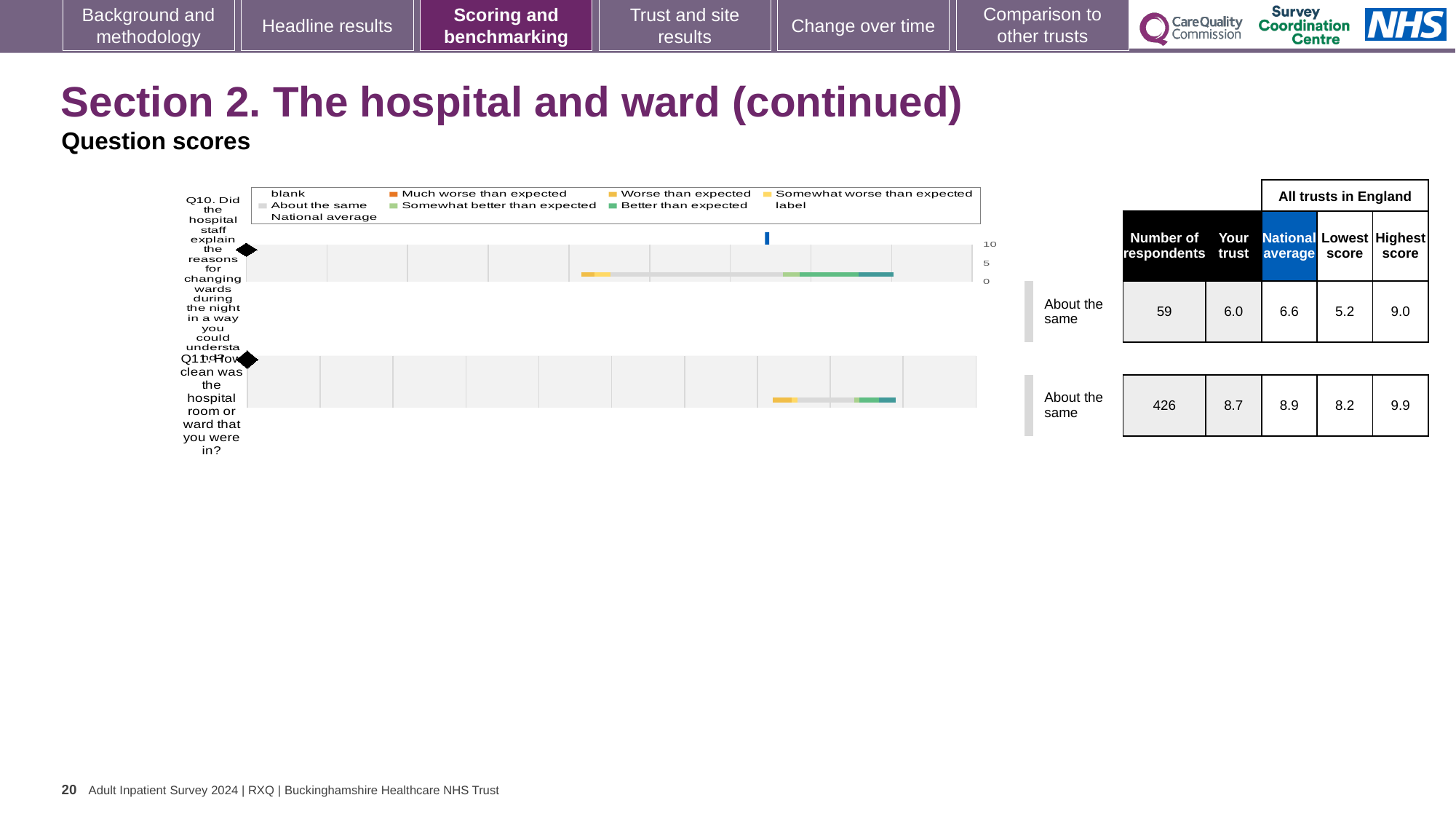
What is the highest score across all trusts in England for Q11? 9.9 How many respondents answered Q11? 426 What benchmarking category is the trust's score for Q10 placed in? About the same What is the 'Your trust' score for Q11 (How clean was the hospital room or ward that you were in?)? 8.7 What is the national average score for Q10 (Did the hospital staff explain the reasons for changing wards during the night)? 6.6 What is the lowest score across all trusts in England for Q10? 5.2 What is the difference between the highest and lowest scores across all trusts for Q10? 3.8 Which is larger for Q11: the 'Your trust' score or the national average? National average What kind of chart is shown on the slide? bar chart What is the difference between the national average and the 'Your trust' score for Q10? 0.6 Which question has the higher 'Your trust' score, Q10 or Q11? Q11 How many questions (bars) are plotted in the chart? 2